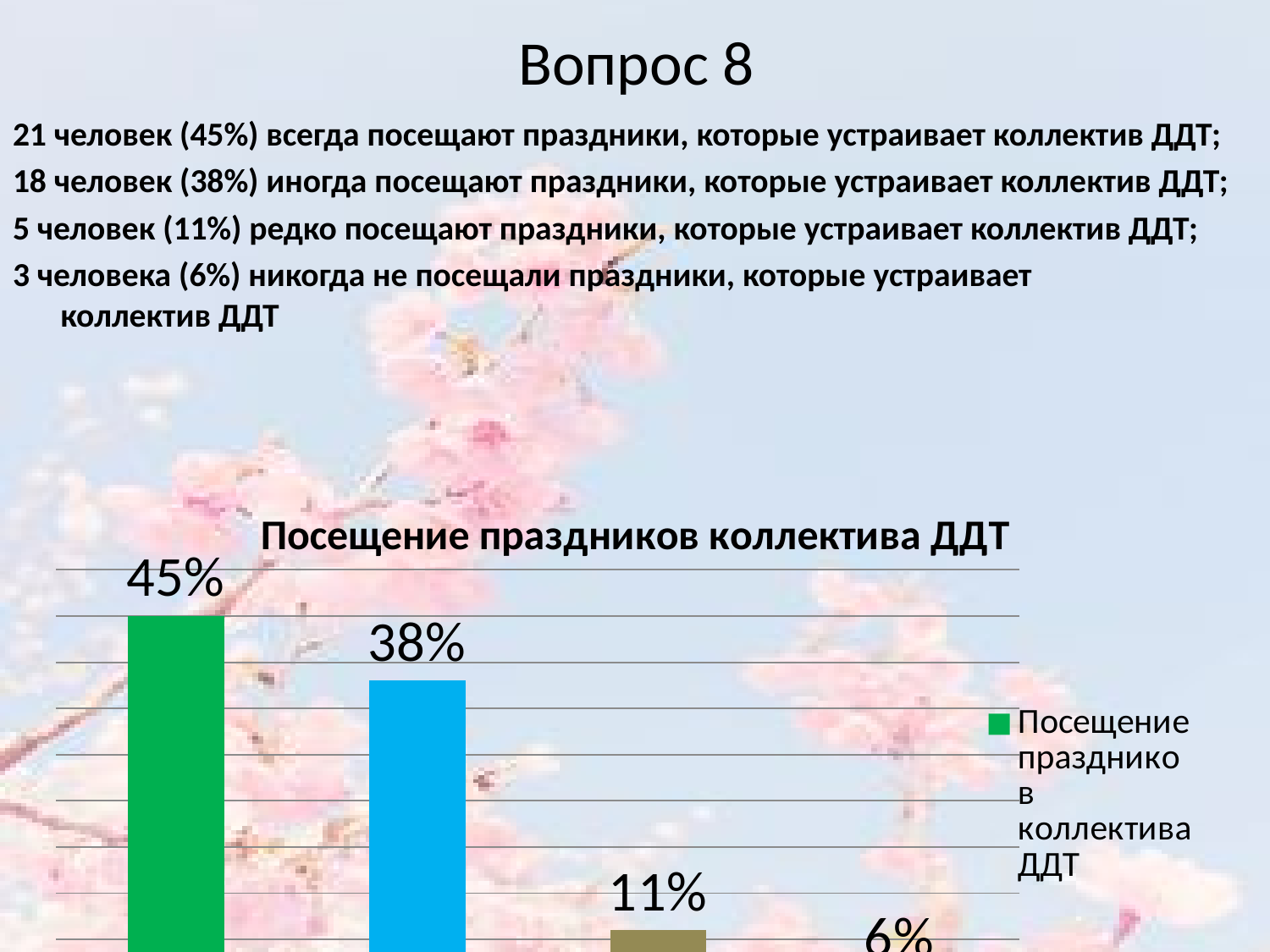
What is the title of the chart on the slide? Посещение праздников коллектива ДДТ What is the value shown on the first (green) bar of the chart? 45% How many bars (data points) does the chart show? 4 What kind of chart is shown on the slide? bar chart How many series does the chart's legend list? 1 Do the bar values rise or fall from left to right across the chart? fall Which bar has the lowest value in the chart? the fourth bar, 6% What is the value shown on the third (olive) bar of the chart? 11% What is the value shown on the fourth bar of the chart? 6% What is the difference between the first bar (45%) and the second bar (38%)? 7% What is the value shown on the second (blue) bar of the chart? 38% Which bar has the highest value in the chart? the first (green) bar, 45%